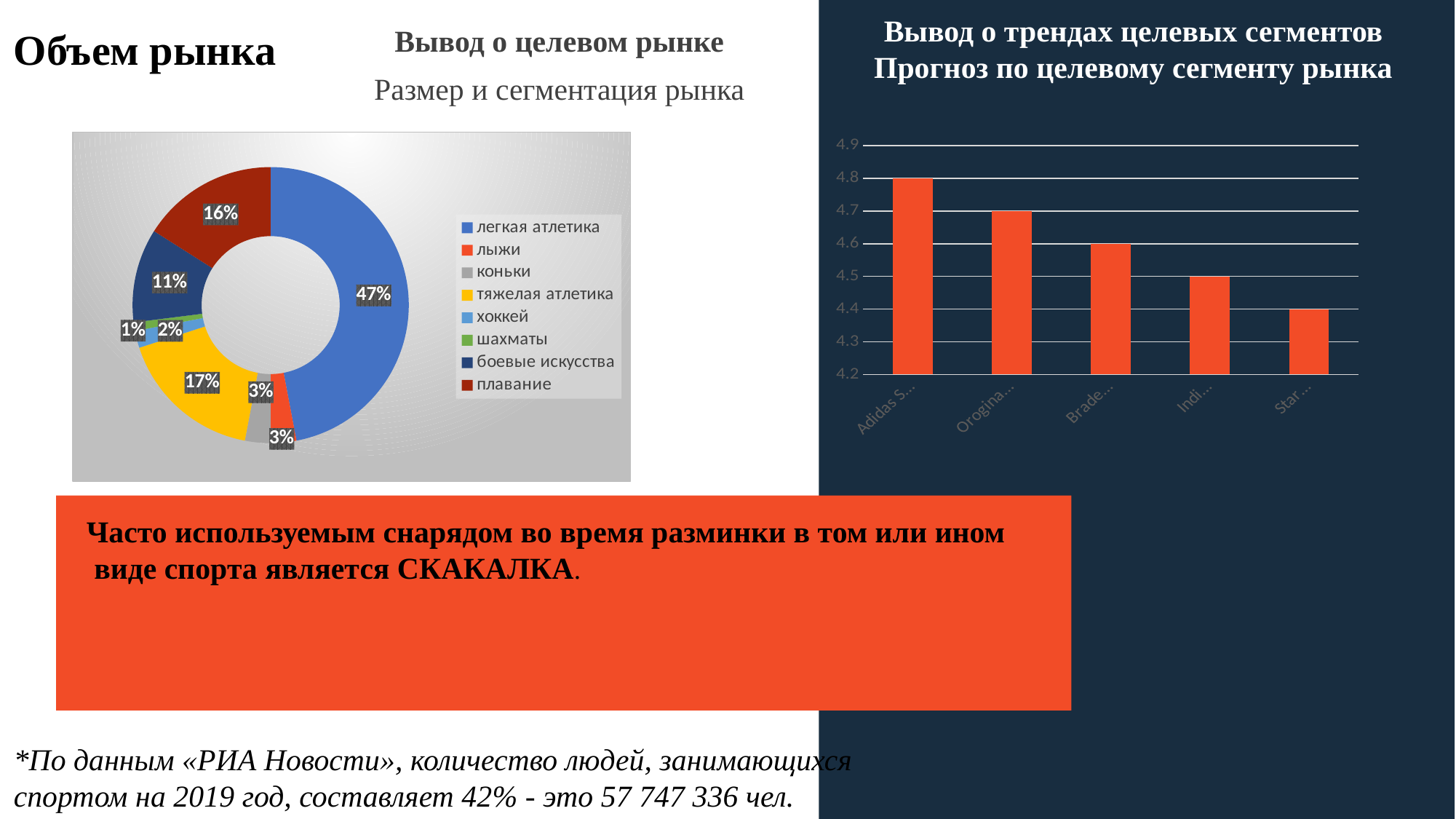
In the doughnut chart on the left, which category has the largest share? легкая атлетика In the doughnut chart on the left, which category has the smallest share? шахматы In the doughnut chart on the left, what share of the market does легкая атлетика hold? 47% In the doughnut chart on the left, which is larger: the share of плавание or the share of боевые искусства? плавание In the bar chart on the right, how many bars are plotted? 5 In the bar chart on the right, do the values rise or fall from left to right? fall In the doughnut chart on the left, what percentage is shown for плавание? 16% In the doughnut chart on the left, what percentage is shown for тяжелая атлетика? 17% In the doughnut chart on the left, what is the difference between the shares of тяжелая атлетика and боевые искусства? 6% In the bar chart on the right, what is the value of the first bar (Adidas S...)? 4.8 What type of chart is shown on the right side of the slide under 'Прогноз по целевому сегменту рынка'? bar chart In the doughnut chart on the left, how many categories does the legend list? 8